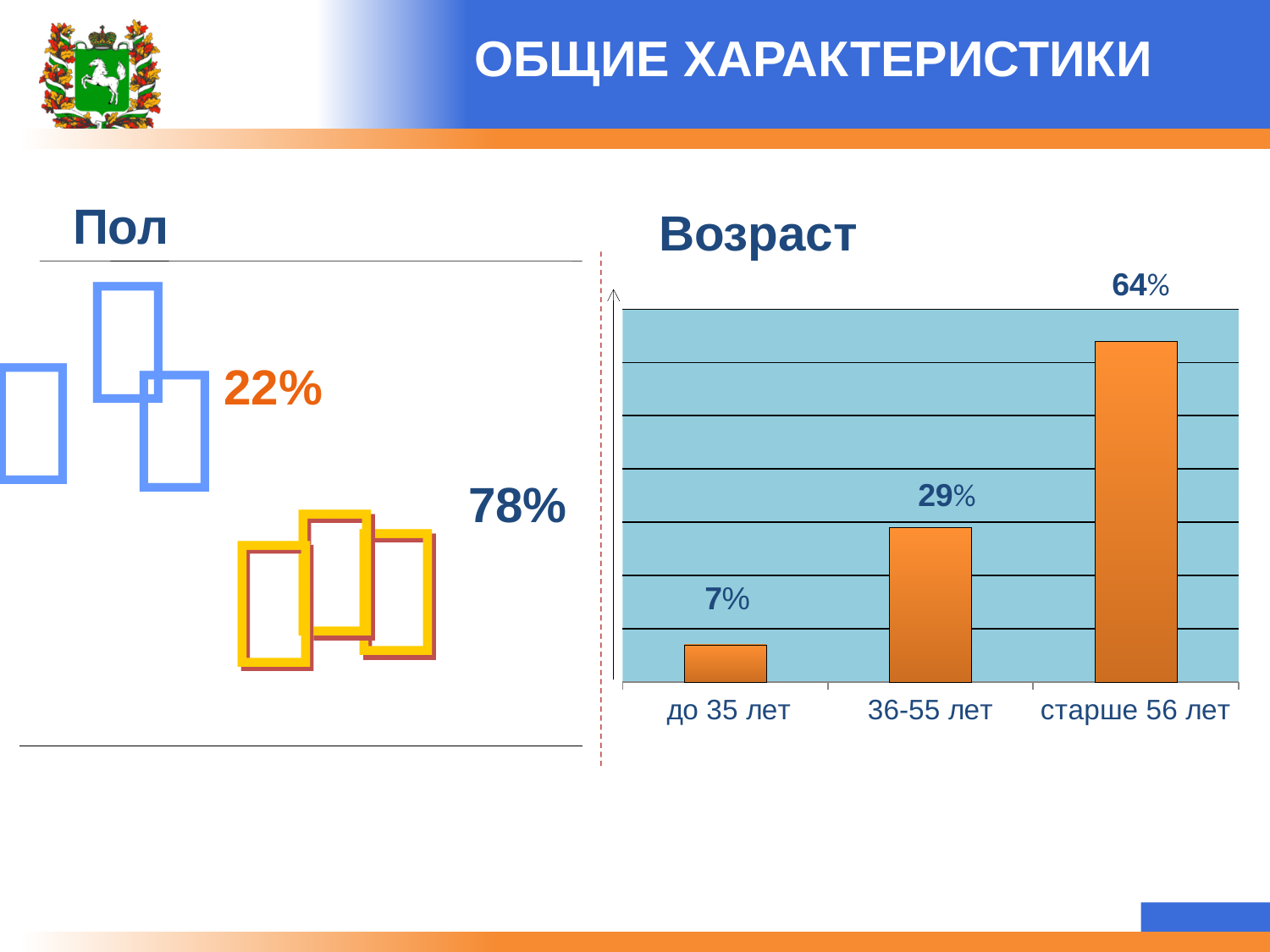
In the "Возраст" chart, what is the value for "старше 56 лет"? 64% In the "Возраст" chart, what is the difference between the values for "36-55 лет" and "до 35 лет"? 22% In the "Возраст" chart, do the values rise or fall from left to right along the x axis? rise In the "Возраст" chart, what is the value for "36-55 лет"? 29% In the "Возраст" chart, which age group has the lowest value? до 35 лет What kind of chart is the "Возраст" chart? bar chart In the "Возраст" chart, which age group has the highest value? старше 56 лет What is the title of the bar chart on the right side of the slide? Возраст In the "Возраст" chart, what is the difference between the values for "старше 56 лет" and "36-55 лет"? 35% How many age categories are shown in the "Возраст" chart? 3 In the "Возраст" chart, which is larger: the value for "36-55 лет" or for "до 35 лет"? 36-55 лет In the "Возраст" chart, what is the value for "до 35 лет"? 7%